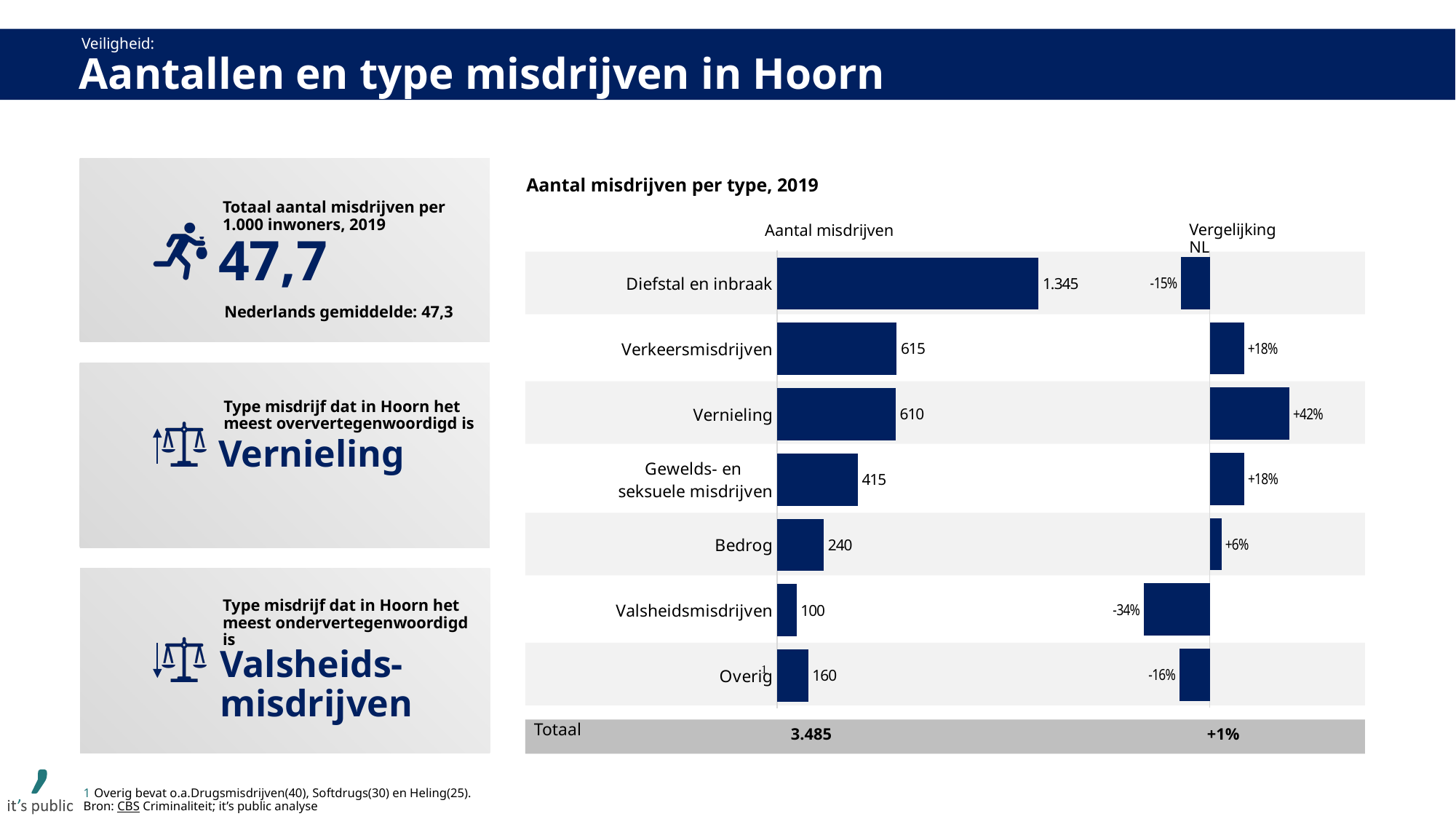
In the chart 'Aantal misdrijven per type, 2019', which has a higher Aantal misdrijven: Gewelds- en seksuele misdrijven or Overig? Gewelds- en seksuele misdrijven In the chart 'Aantal misdrijven per type, 2019', what is the Aantal misdrijven value for Diefstal en inbraak? 1.345 What kind of chart is 'Aantal misdrijven per type, 2019'? Bar chart In the chart 'Aantal misdrijven per type, 2019', how many crime types are shown (excluding the Totaal row)? 7 In the chart 'Aantal misdrijven per type, 2019', what is the Vergelijking NL value for Valsheidsmisdrijven? -34% In the chart 'Aantal misdrijven per type, 2019', what is the Vergelijking NL value for Vernieling? +42% In the chart 'Aantal misdrijven per type, 2019', what is the Aantal misdrijven value for Bedrog? 240 In the chart 'Aantal misdrijven per type, 2019', what is the Vergelijking NL value for Diefstal en inbraak? -15% In the chart 'Aantal misdrijven per type, 2019', what is the difference in Aantal misdrijven between Verkeersmisdrijven and Vernieling? 5 In the chart 'Aantal misdrijven per type, 2019', what is the Totaal value for Aantal misdrijven? 3.485 In the chart 'Aantal misdrijven per type, 2019', which crime type has the lowest Aantal misdrijven? Valsheidsmisdrijven In the chart 'Aantal misdrijven per type, 2019', which crime type has the highest Aantal misdrijven? Diefstal en inbraak